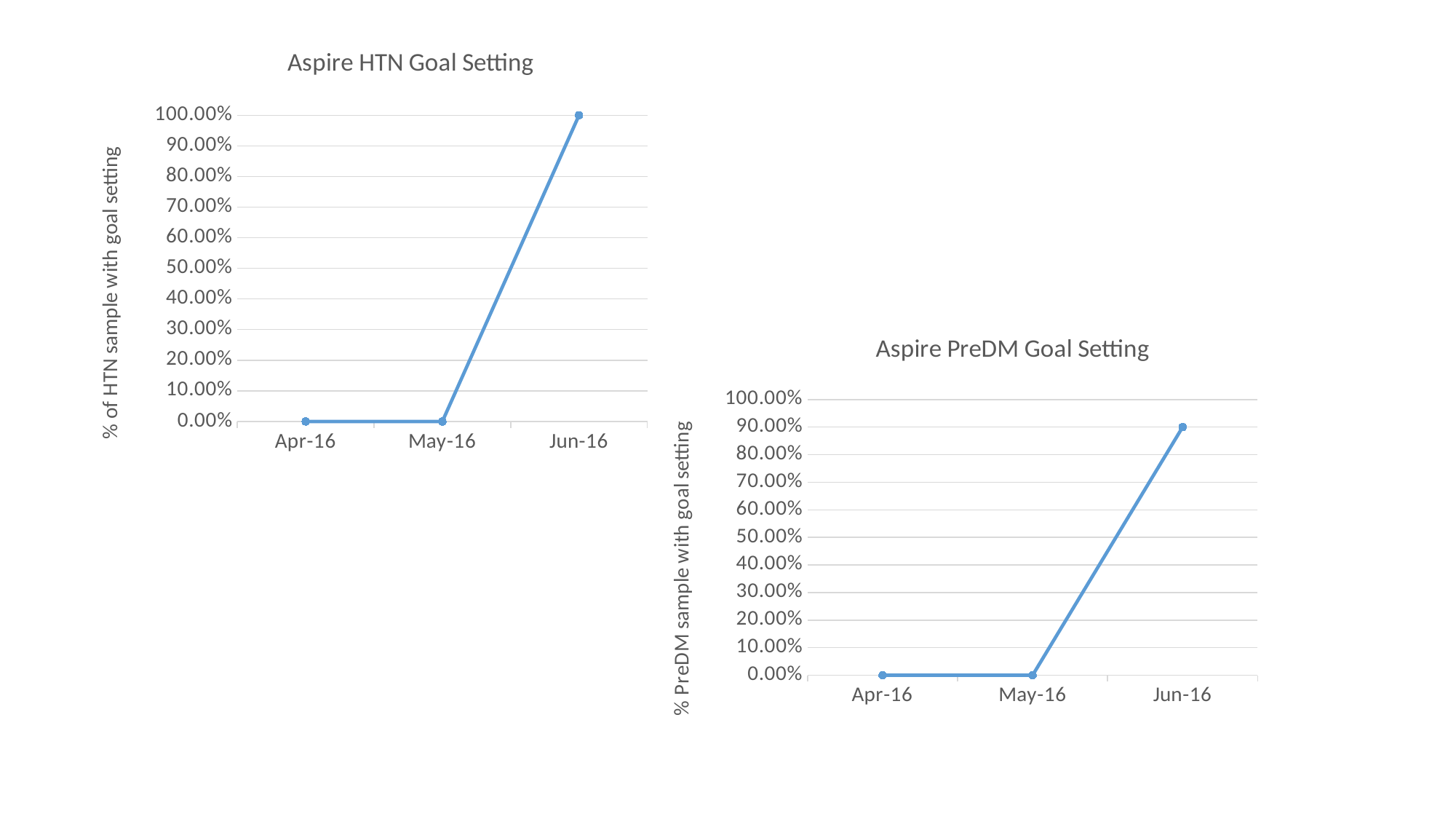
In the Aspire HTN Goal Setting chart, what is the value for Jun-16? 100.00% In the Aspire HTN Goal Setting chart, what is the value for Apr-16? 0.00% Which is larger: the Jun-16 value in the Aspire HTN Goal Setting chart or the Jun-16 value in the Aspire PreDM Goal Setting chart? Aspire HTN Goal Setting What kind of chart is the Aspire PreDM Goal Setting chart? line chart In the Aspire PreDM Goal Setting chart, what is the value for Jun-16? 90.00% In the Aspire PreDM Goal Setting chart, is the value for Jun-16 greater or less than 50.00%? greater In the Aspire PreDM Goal Setting chart, which month has the highest value? Jun-16 In the Aspire PreDM Goal Setting chart, what is the value for May-16? 0.00% In the Aspire HTN Goal Setting chart, which month has the highest value? Jun-16 What is the y-axis label of the Aspire HTN Goal Setting chart? % of HTN sample with goal setting How many data points are plotted in the Aspire HTN Goal Setting chart? 3 In the Aspire PreDM Goal Setting chart, what is the difference between the Jun-16 and May-16 values? 90.00%